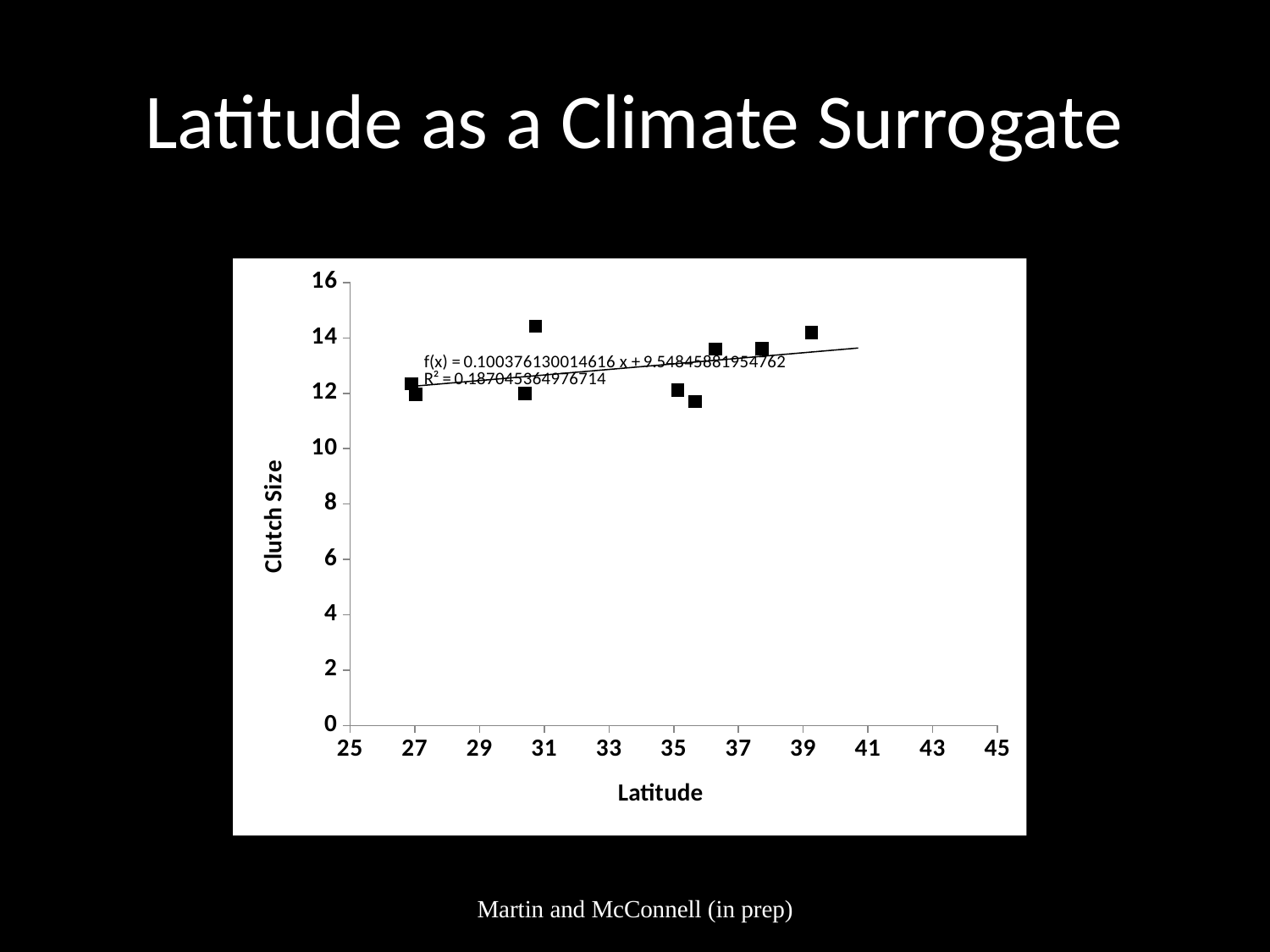
What is the slope of the fitted line f(x) printed on the chart? 0.100376130014616 Is the clutch size of the lowest point near latitude 36 greater or less than 12? less According to the trendline, does clutch size rise or fall as latitude increases? Rise Are all the plotted clutch size values greater or less than 10? greater What is the label of the y axis of the chart? Clutch Size What is the label of the x axis of the chart? Latitude Is the clutch size of the point near latitude 31 that lies above the trendline greater or less than 14? greater What kind of chart is shown on the slide? Scatter plot What is the title of the slide containing the chart? Latitude as a Climate Surrogate What R² value is printed on the chart for the trendline? 0.187045364976714 What is the intercept of the fitted line f(x) printed on the chart? 9.54845881954762